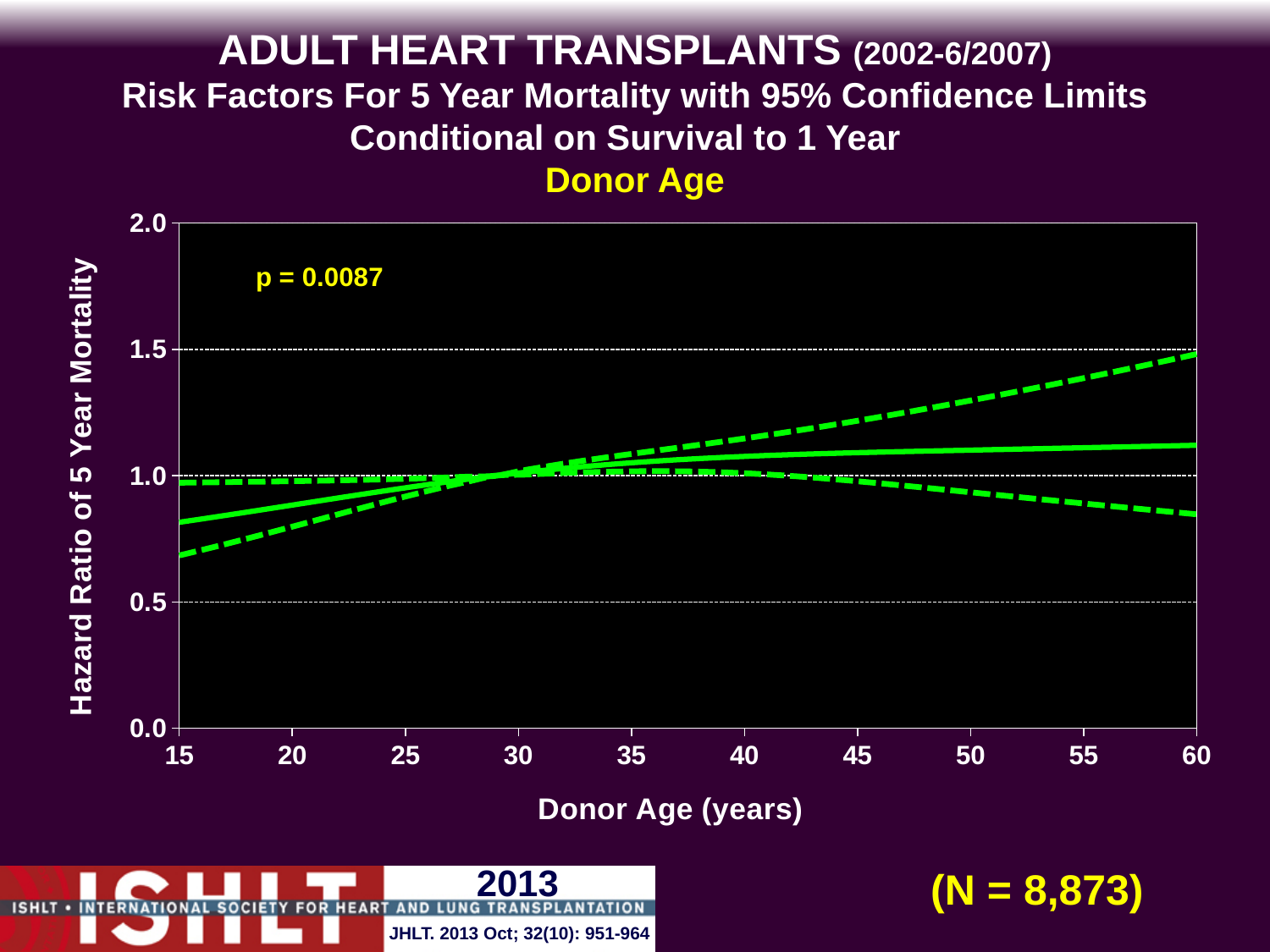
What p-value is printed on the chart? p = 0.0087 Is the hazard ratio (solid line) at donor age 60 greater or less than 1.0? greater Is the lower 95% confidence limit (lower dashed line) at donor age 60 greater or less than 1.0? less Is the hazard ratio (solid line) at donor age 15 greater or less than 1.0? less How many lines are plotted on the chart? 3 What kind of chart is shown on the slide? line chart Does the solid hazard ratio line rise or fall as donor age increases from 15 to 60 years? rise What is the label of the y axis? Hazard Ratio of 5 Year Mortality Is the hazard ratio (solid line) higher at donor age 60 or at donor age 15? 60